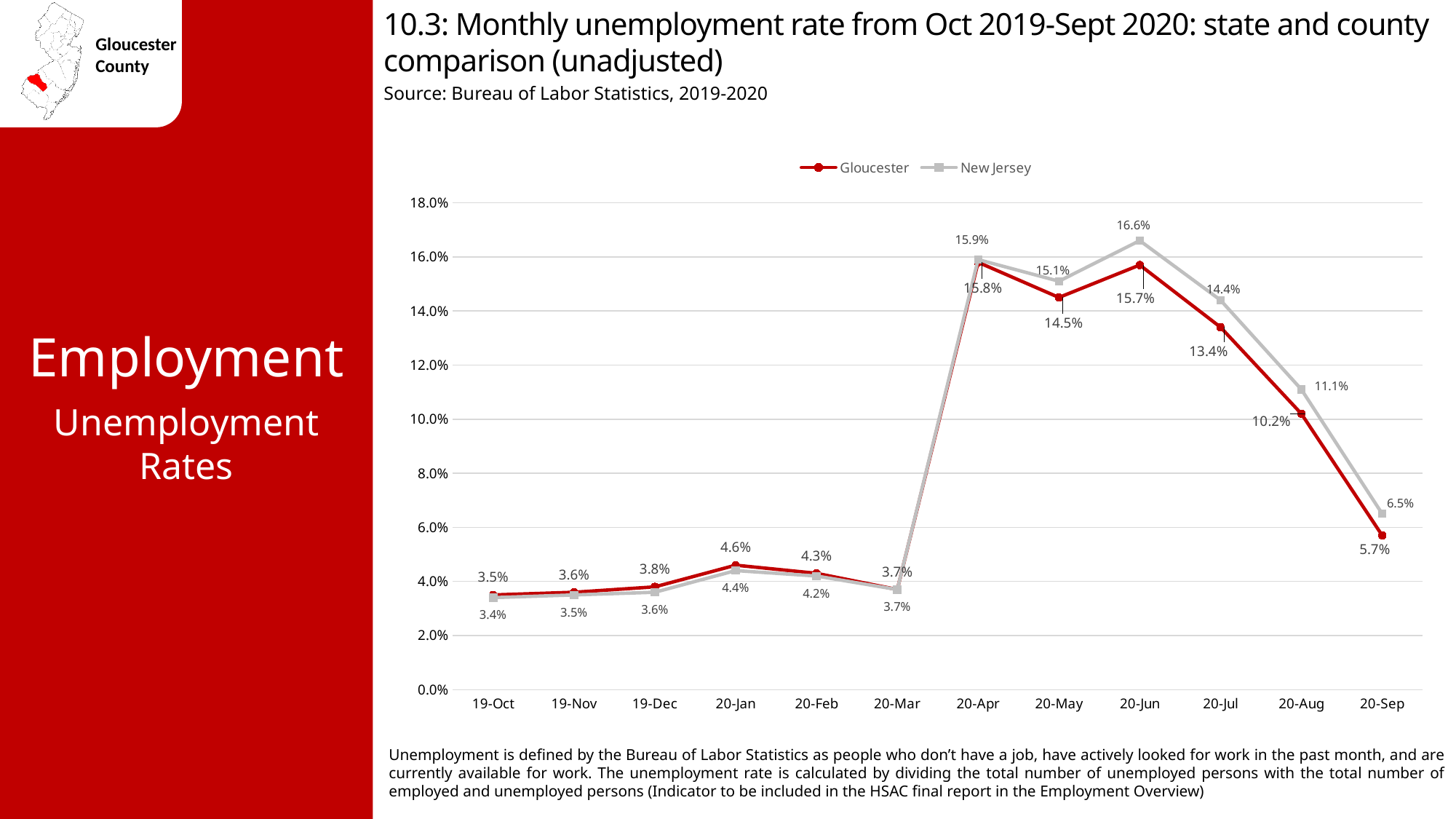
In which month is the Gloucester unemployment rate lowest? 19-Oct What is the New Jersey unemployment rate for 20-Jun? 16.6% Is the Gloucester value for 20-Aug greater or less than 12.0%? less What is the New Jersey unemployment rate for 19-Oct? 3.4% What is the Gloucester unemployment rate for 20-Sep? 5.7% What is the Gloucester unemployment rate for 20-May? 14.5% How many months are plotted on the x axis? 12 What kind of chart is shown on the slide? Line chart In which month does the New Jersey series reach its highest value? 20-Jun What is the difference between the New Jersey and Gloucester rates in 20-Jul? 1.0% In 20-Jan, which series has the higher unemployment rate, Gloucester or New Jersey? Gloucester How many series does the legend list? 2